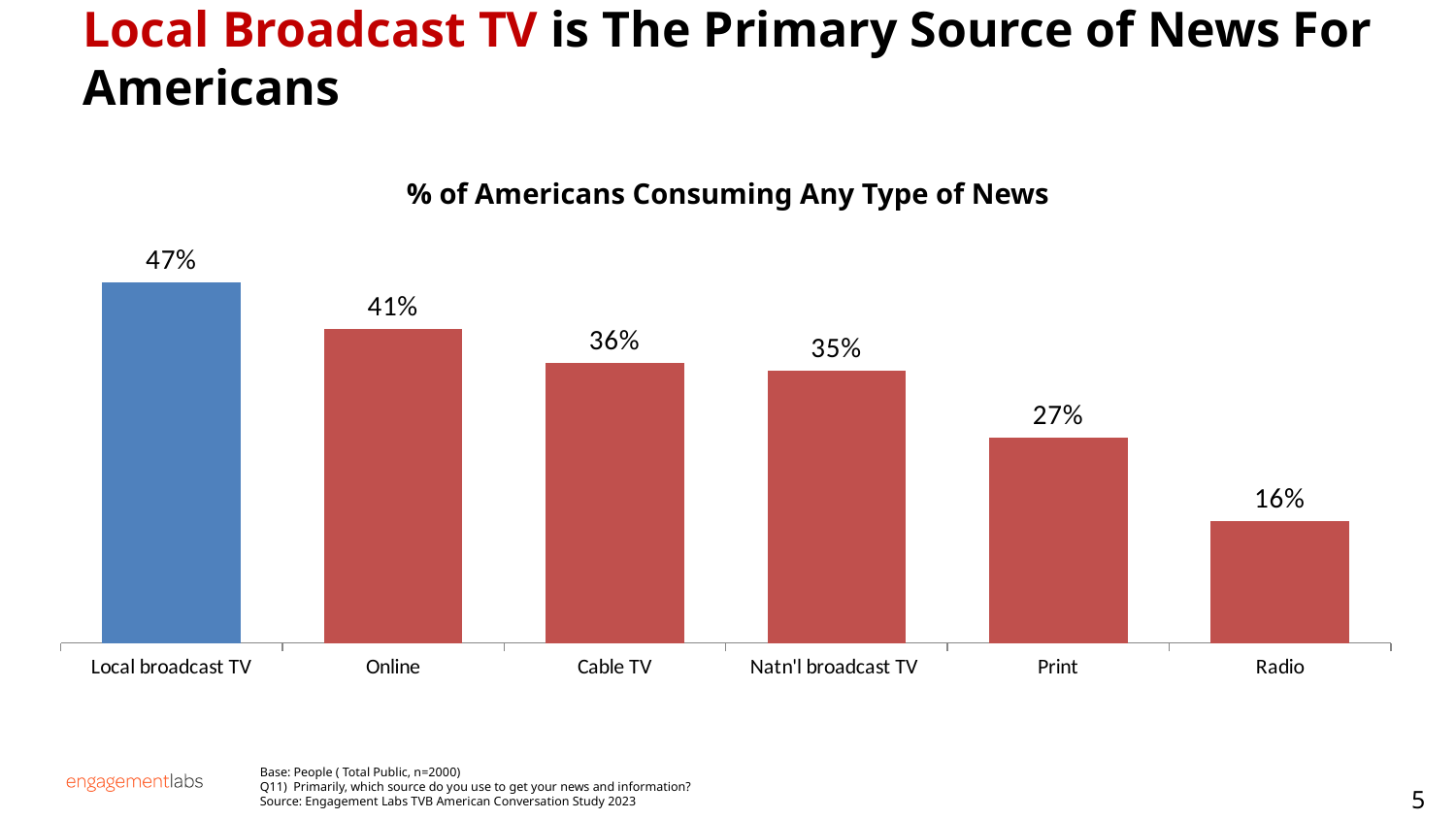
Which news source has the lowest percentage? Radio What kind of chart is shown on the slide? Bar chart What is the title of the chart? % of Americans Consuming Any Type of News How many news sources are shown in the chart? 6 What is the value shown for Online? 41% What is the value shown for Print? 27% What is the difference between the values for Local broadcast TV and Online? 6% What percentage of Americans use Local broadcast TV as their primary news source? 47% What is the value shown for Radio? 16% Which is larger, the value for Cable TV or the value for Natn'l broadcast TV? Cable TV What is the difference between the values for Print and Radio? 11% Which news source has the highest percentage? Local broadcast TV